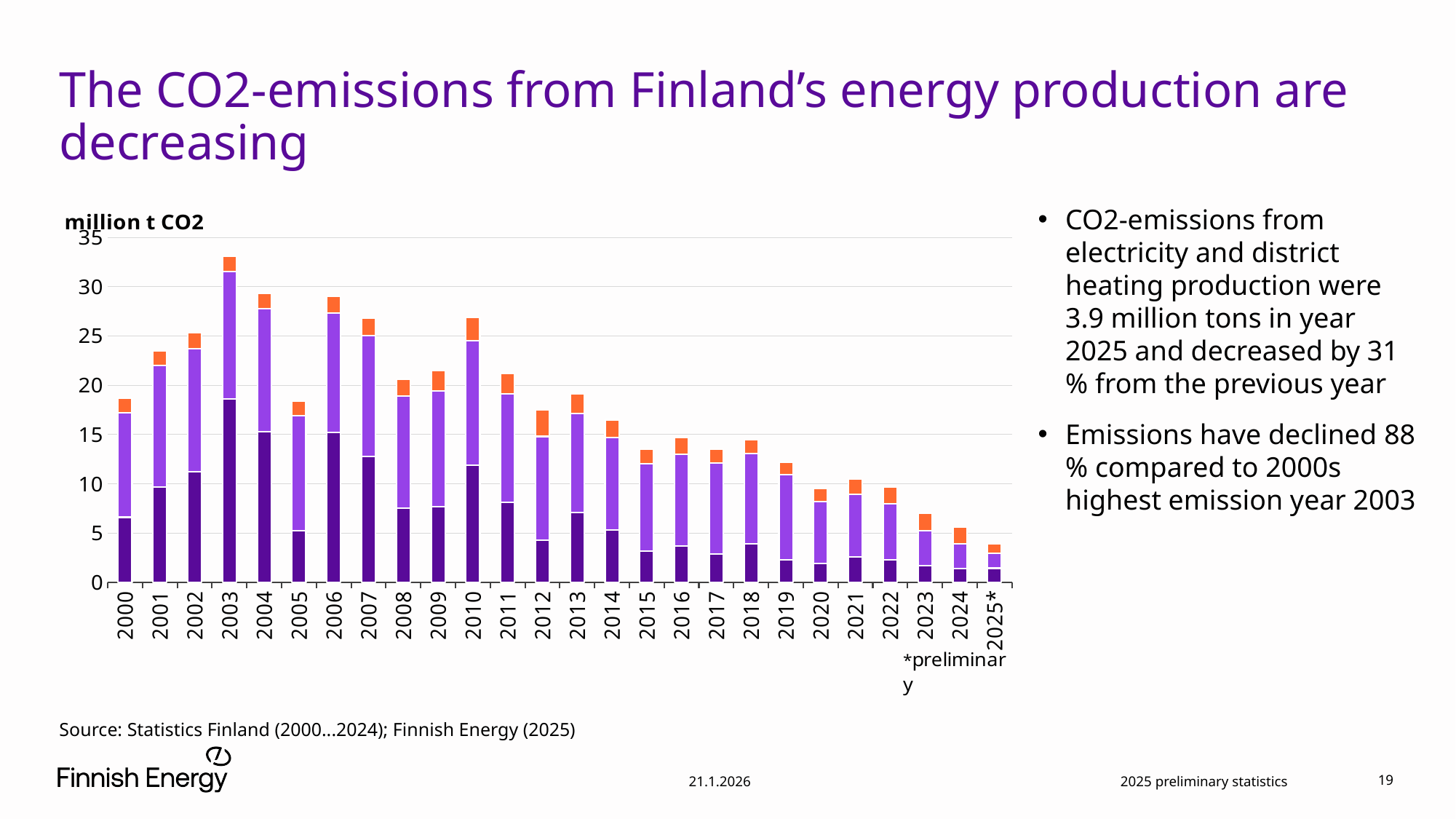
Do the total emissions generally rise or fall from 2010 to 2025*? fall Which year has a higher total, 2010 or 2011? 2010 Is the total value for 2000 greater or less than 20? less Is the total value for 2015 greater or less than 10? greater How many years (bars) are plotted on the chart? 26 Which year has the highest total CO2 emissions on the chart? 2003 Which year has the lowest total CO2 emissions on the chart? 2025* Is the total value for 2025* greater or less than 5? less What kind of chart is shown on the slide? Stacked bar chart What unit is shown above the vertical axis of the chart? million t CO2